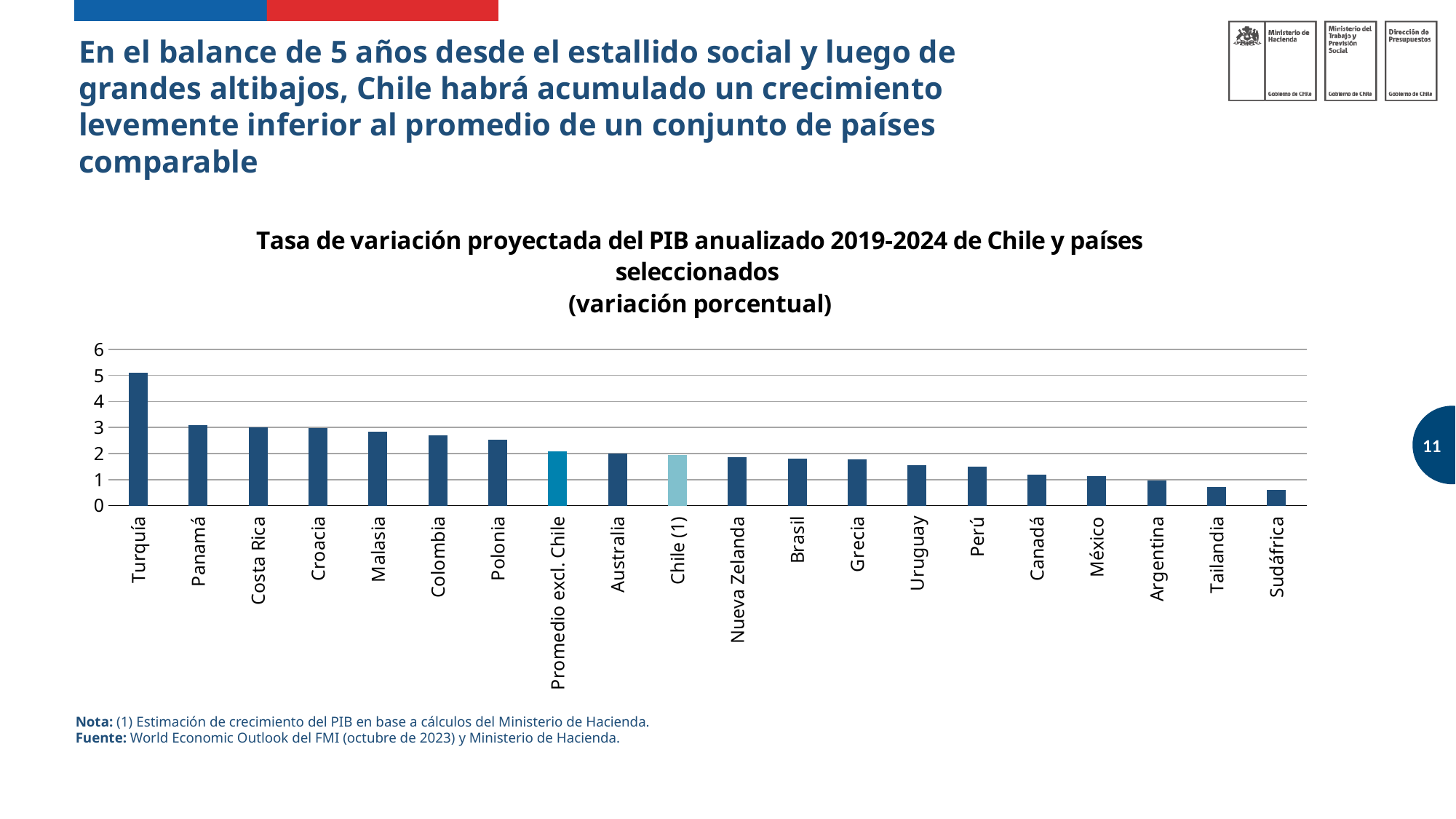
Is the value for Sudáfrica greater or less than 1? less Which has a larger value, Colombia or Brasil? Colombia What kind of chart is shown on the slide? bar chart Which has a larger value, Turquía or Panamá? Turquía Is the value for Colombia greater or less than 2? greater Is the value for Turquía greater or less than 4? greater Which category has the lowest projected annualized GDP growth rate in the chart? Sudáfrica How many countries or categories are plotted on the x axis of the chart? 20 Do the values generally rise or fall moving from left to right along the x axis? fall Which category has the highest projected annualized GDP growth rate in the chart? Turquía